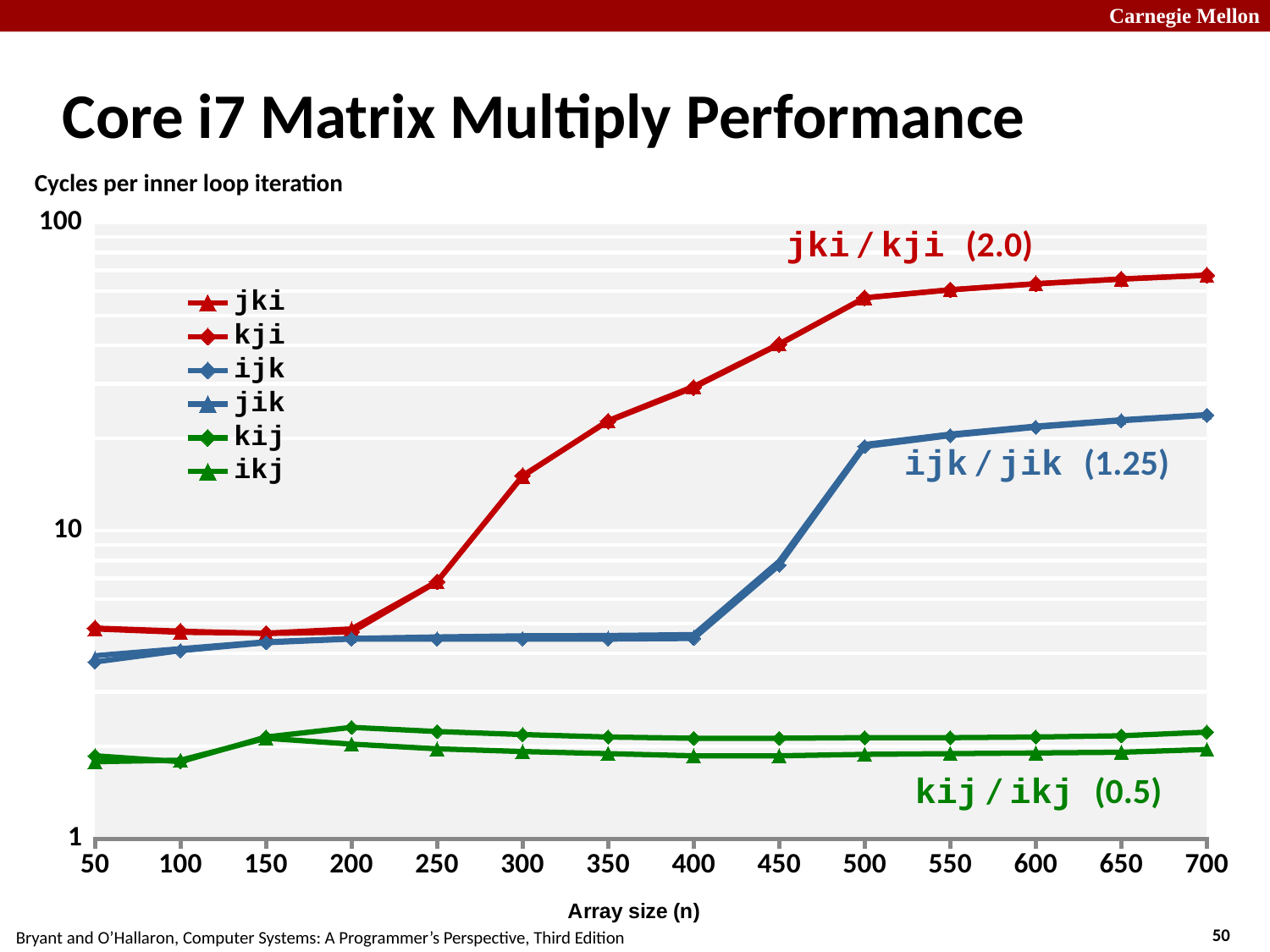
What is the label of the x axis? Array size (n) How many series does the legend list? 6 At array size 700, which is larger, the value for jki or the value for ijk? jki How many array size values are marked along the x axis? 14 At array size 700, which is larger, the value for kij or the value for ijk? ijk What kind of chart is shown on the slide? line chart Is the value for ijk at array size 400 greater or less than 10? less Do the values for jki rise or fall as the array size increases from 50 to 700? rise Is the value for jki at array size 700 greater or less than 10? greater Is the value for kij at array size 700 greater or less than 10? less